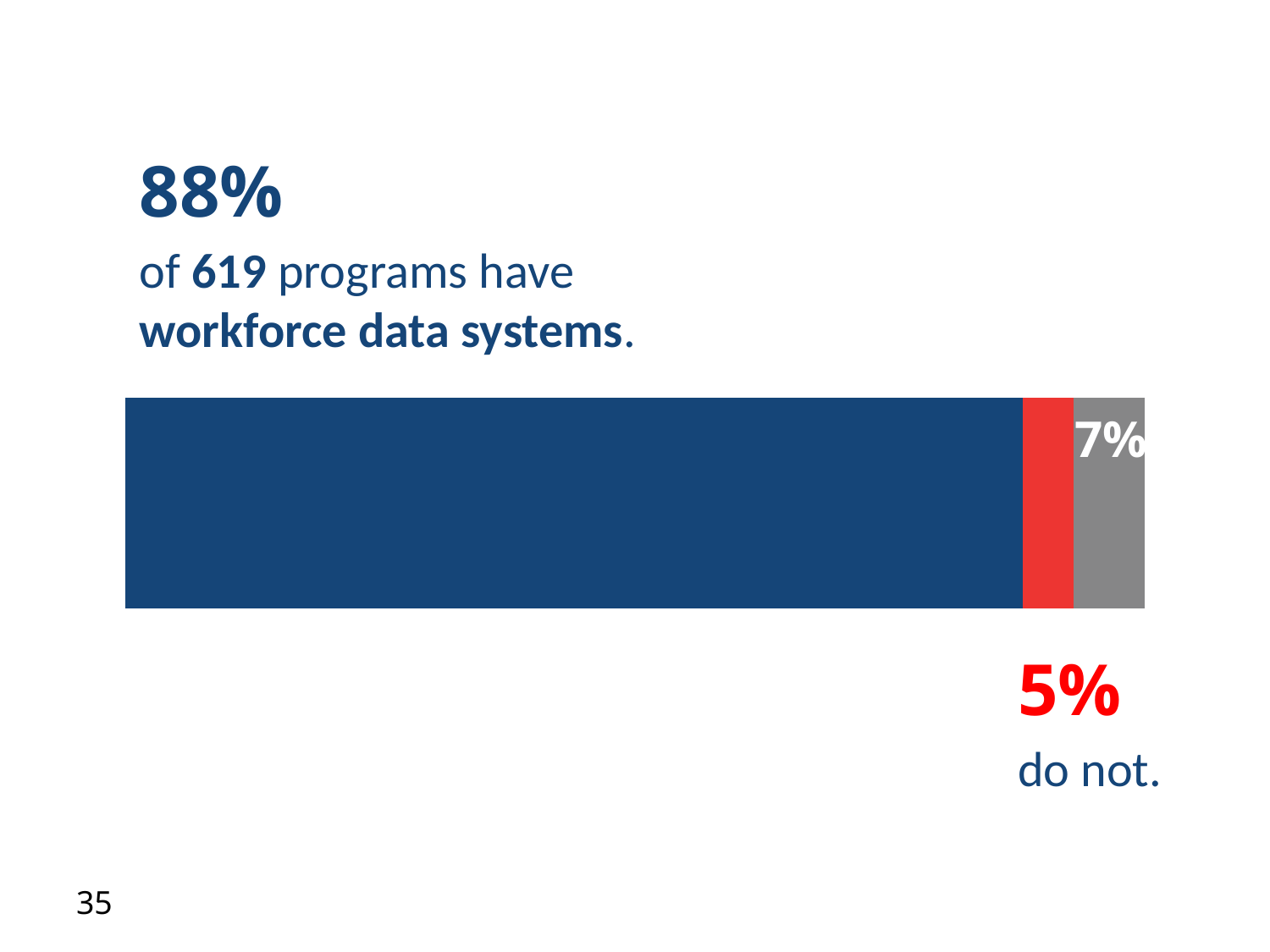
What is the difference between the gray segment's value and the red segment's value? 2 percentage points What percentage of the 619 programs have workforce data systems? 88% Which is larger, the gray segment or the red segment? The gray segment What value is printed on the gray segment of the bar? 7% How many segments make up the bar? 3 What do the three segments of the bar add up to? 100% How many programs does the chart cover in total? 619 Which segment of the bar is the largest? The blue segment (88%, programs with workforce data systems) Which segment of the bar is the smallest? The red segment (5%, programs that do not) What kind of chart is shown on the slide? A stacked horizontal bar chart What percentage of programs do not have workforce data systems? 5% What is the difference in percentage points between programs that have workforce data systems and those that do not? 83 percentage points